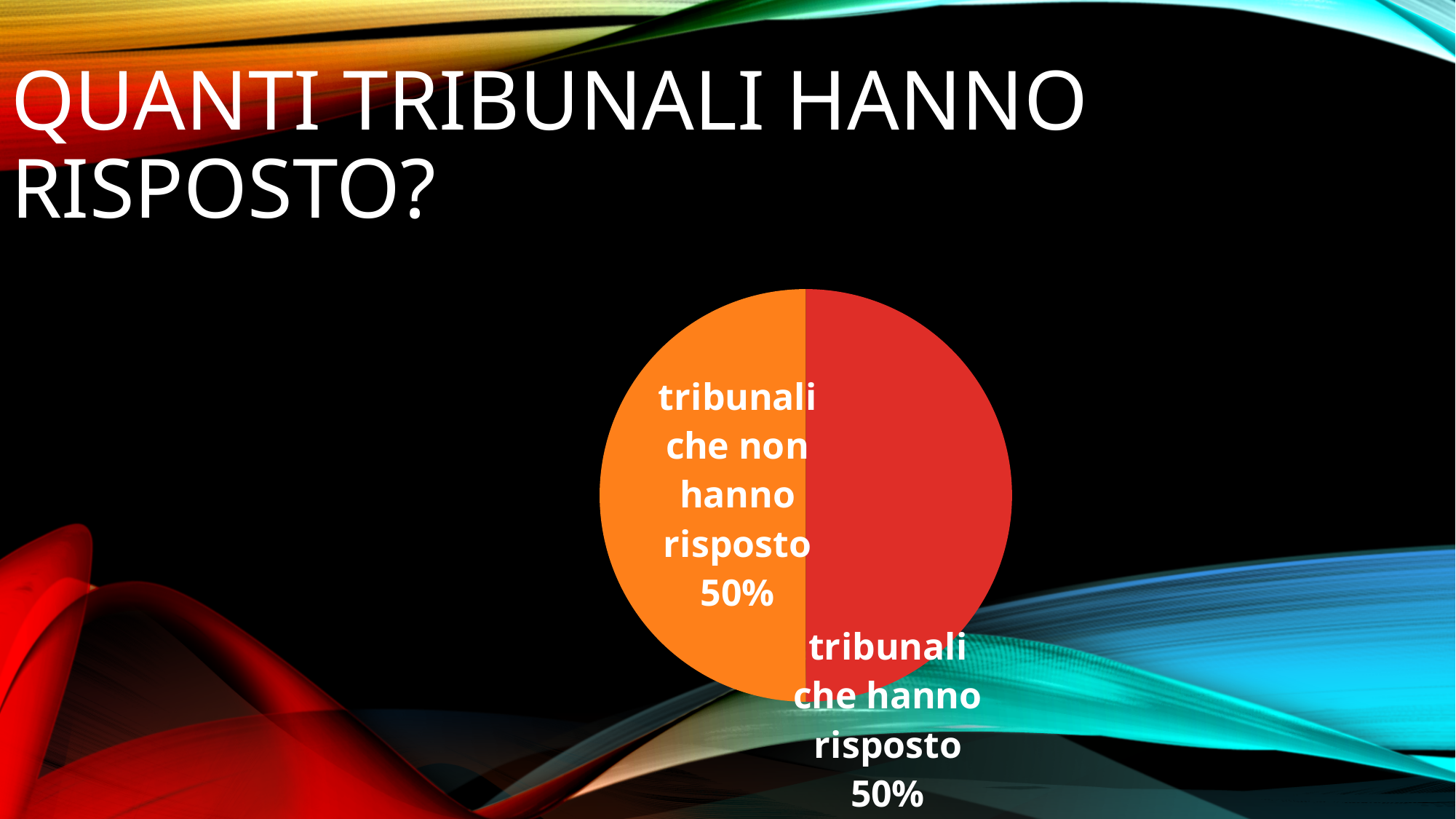
What colour is the slice labelled 'tribunali che hanno risposto'? red What is the total of the two slices shown in the pie chart? 100% What share of the pie is labelled 'tribunali che non hanno risposto'? 50% What is the difference between the share for 'tribunali che hanno risposto' and the share for 'tribunali che non hanno risposto'? 0% What share of the pie is labelled 'tribunali che hanno risposto'? 50% What kind of chart is shown on the slide? pie chart How many slices does the pie chart have? 2 What colour is the slice labelled 'tribunali che non hanno risposto'? orange